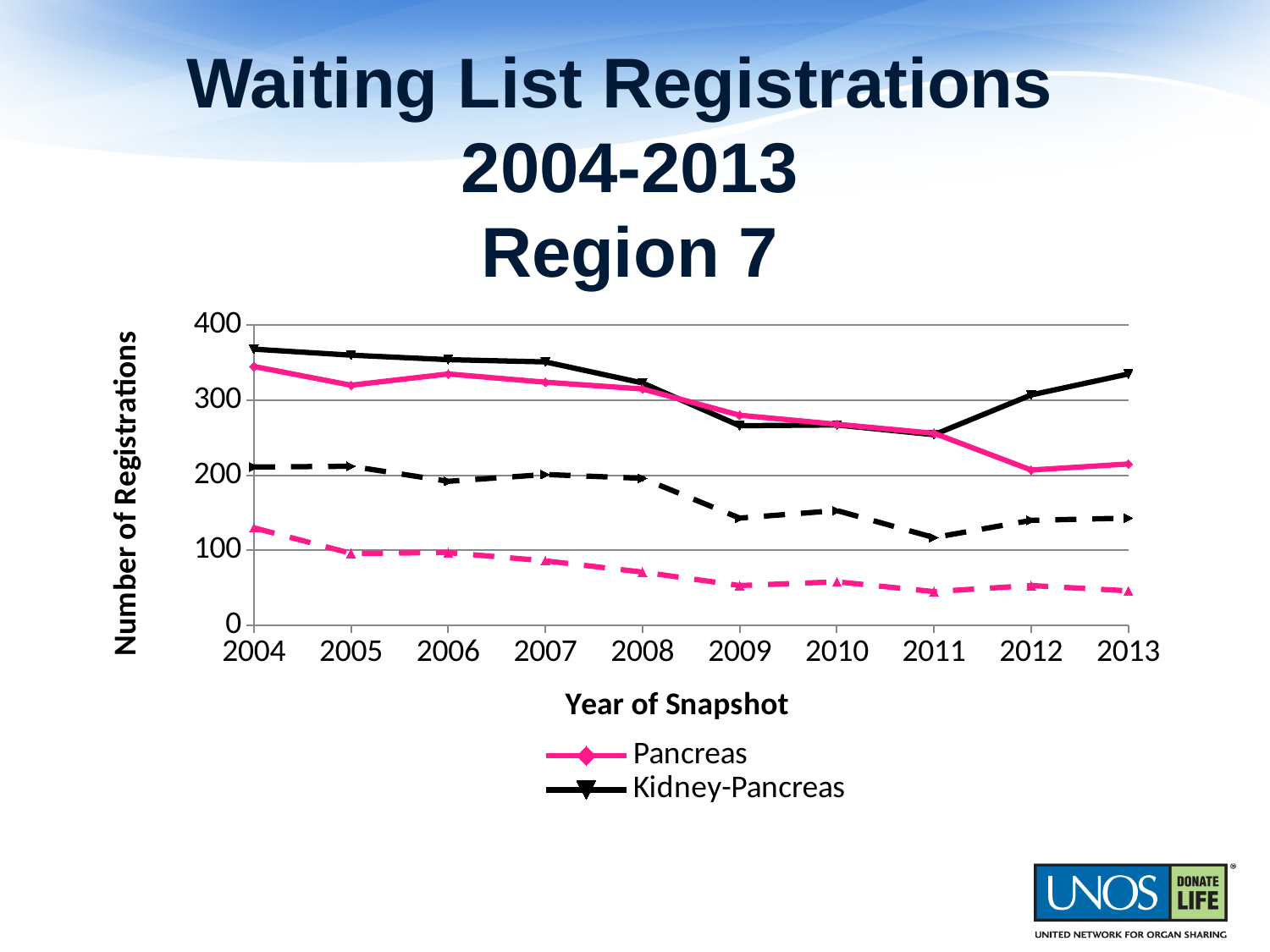
Which series has the higher value in 2012, Pancreas or Kidney-Pancreas? Kidney-Pancreas How many years are shown along the x axis? 10 Does the Pancreas series rise or fall overall from 2004 to 2013? fall Is the value for Kidney-Pancreas in 2013 greater or less than 300? greater What is the label of the y axis? Number of Registrations Is the value for Kidney-Pancreas in 2011 greater or less than 300? less Is the value for Pancreas in 2004 greater or less than 300? greater What kind of chart is shown on the slide? line chart Which series has the higher value in 2004, Pancreas or Kidney-Pancreas? Kidney-Pancreas How many series does the legend list? 2 Does the Kidney-Pancreas series rise or fall from 2011 to 2013? rise